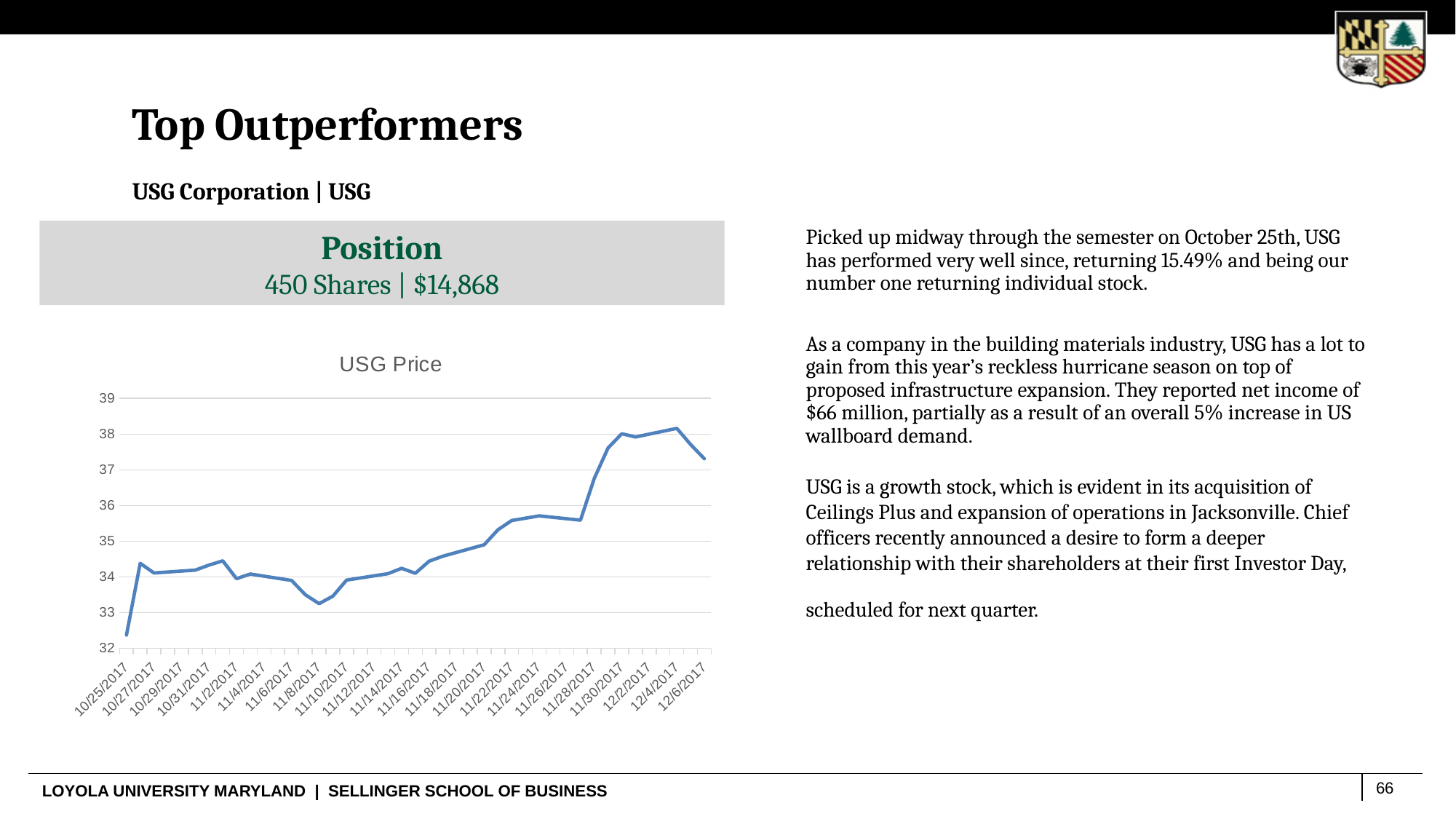
What kind of chart is shown on the slide? line chart Which is larger, the USG price on 12/4/2017 or on 10/25/2017? 12/4/2017 Which is larger, the USG price on 11/2/2017 or on 11/8/2017? 11/2/2017 Which date has the lowest USG price on the chart? 10/25/2017 Is the USG price on 12/4/2017 greater or less than 38? greater Is the USG price on 11/8/2017 greater or less than 34? less What is the title of the chart? USG Price Overall, does the USG price rise or fall from 10/25/2017 to 12/6/2017? rise Is the USG price on 10/25/2017 greater or less than 33? less Which date has the highest USG price on the chart? 12/4/2017